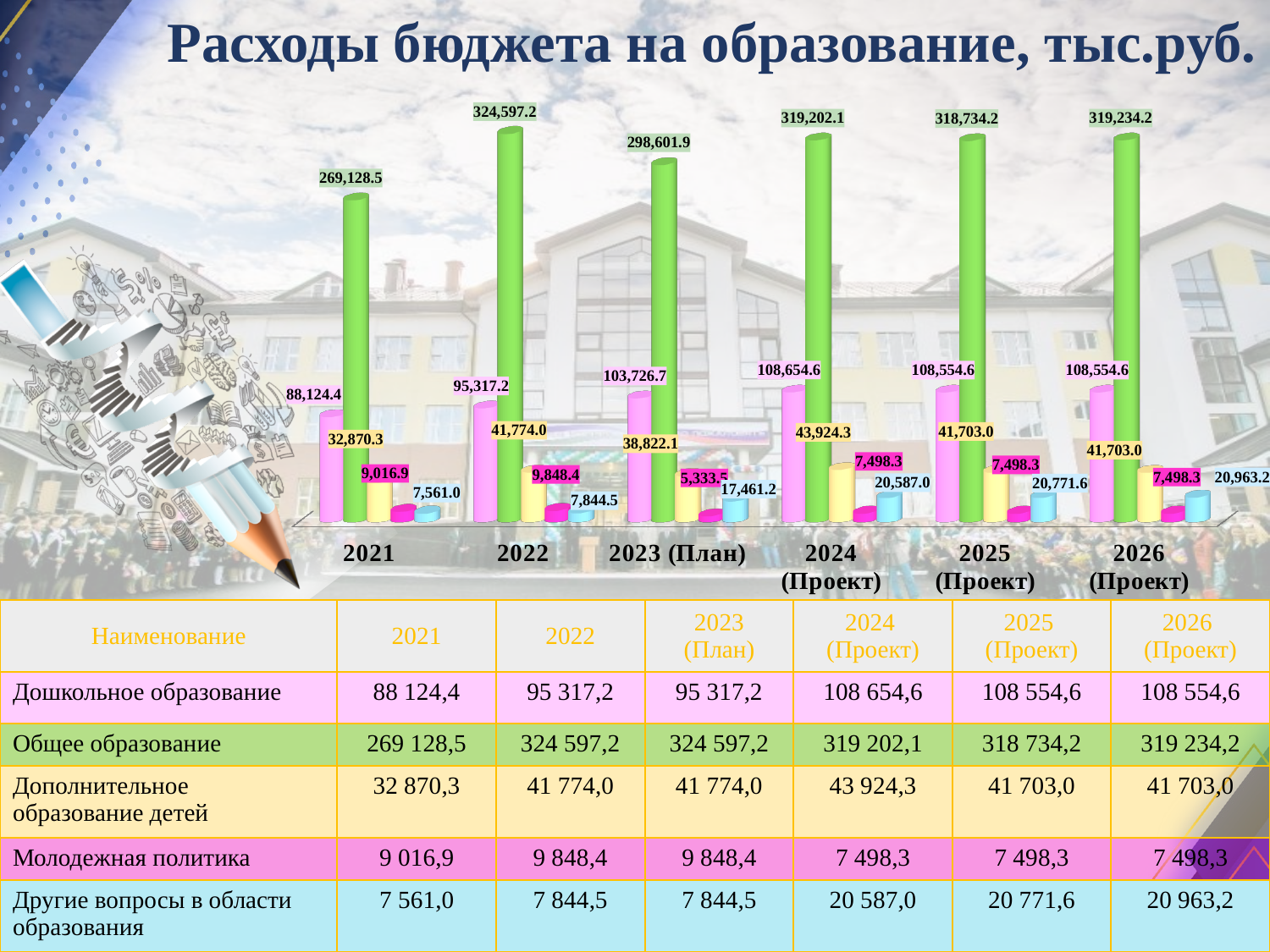
In which year is the green bar (Общее образование) lowest? 2021 Which is larger: the pink bar for 2021 or the pink bar for 2022? 2022 In which year does the green bar (Общее образование) reach its highest value? 2022 What is the title of the chart? Расходы бюджета на образование, тыс.руб. What value is labelled on the yellow bar (Дополнительное образование детей) for 2024 (Проект)? 43,924.3 How many year categories are shown on the x axis of the chart? 6 What is the data label on the green bar (Общее образование) for 2021? 269,128.5 By how much does the green bar value for 2022 exceed the green bar value for 2021? 55,468.7 What type of chart is shown on the slide? Bar chart What is the data label on the light blue bar (Другие вопросы в области образования) for 2026 (Проект)? 20,963.2 What is the difference between the light blue bar values for 2024 (Проект) and 2021? 13,026.0 What value is shown on the pink bar (Дошкольное образование) for 2023 (План)? 103,726.7